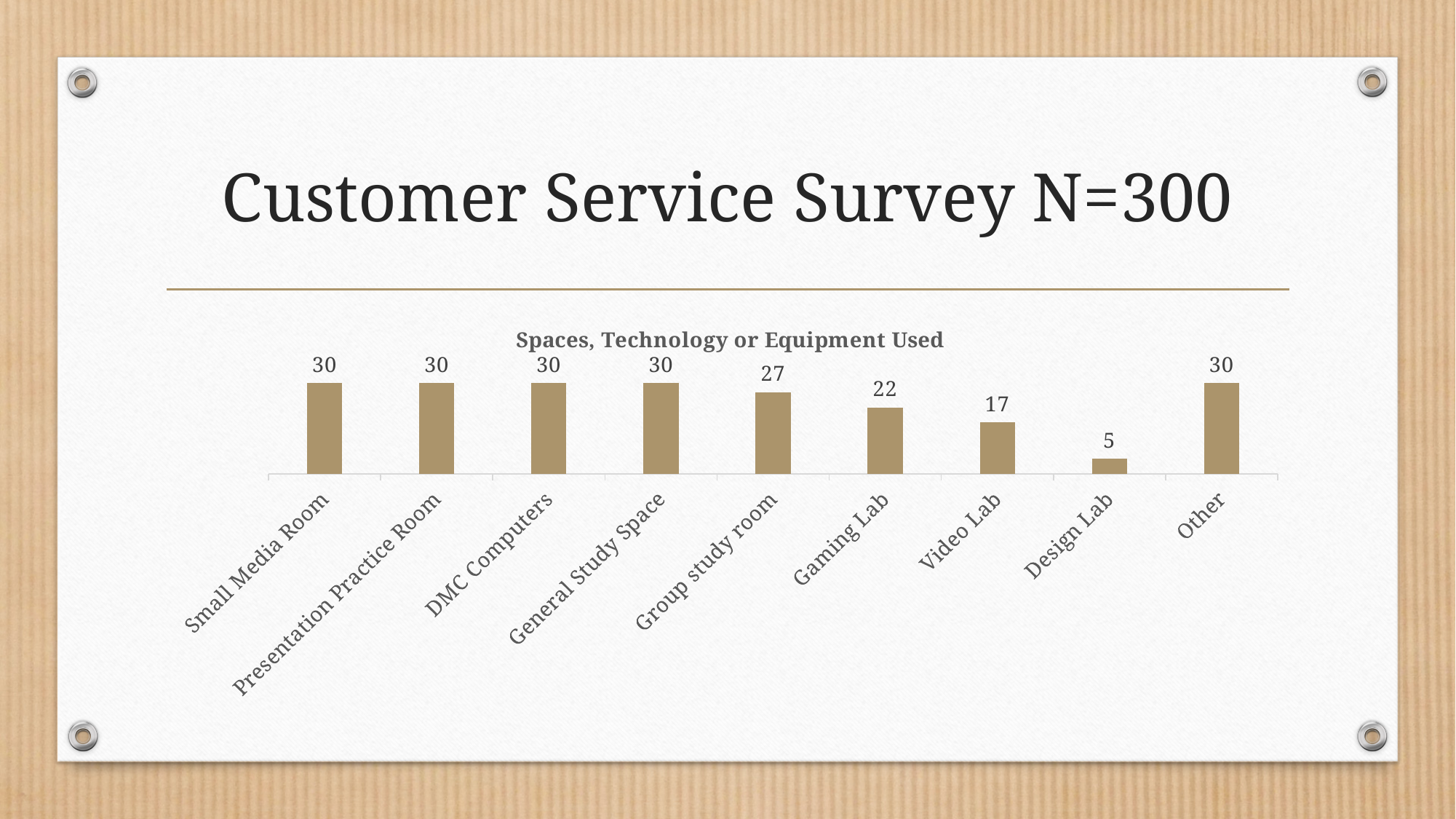
Which category has the lowest value? Design Lab What is the value for Video Lab? 17 What is the value for Gaming Lab? 22 What is the title of the chart? Spaces, Technology or Equipment Used How many categories are shown in the chart? 9 What is the value for Group study room? 27 What is the difference between the values for Small Media Room and Design Lab? 25 What kind of chart is shown on the slide? Bar chart What is the value for Other? 30 What is the value for Design Lab? 5 What is the difference between the values for Gaming Lab and Video Lab? 5 Which is larger, the value for Group study room or the value for Gaming Lab? Group study room